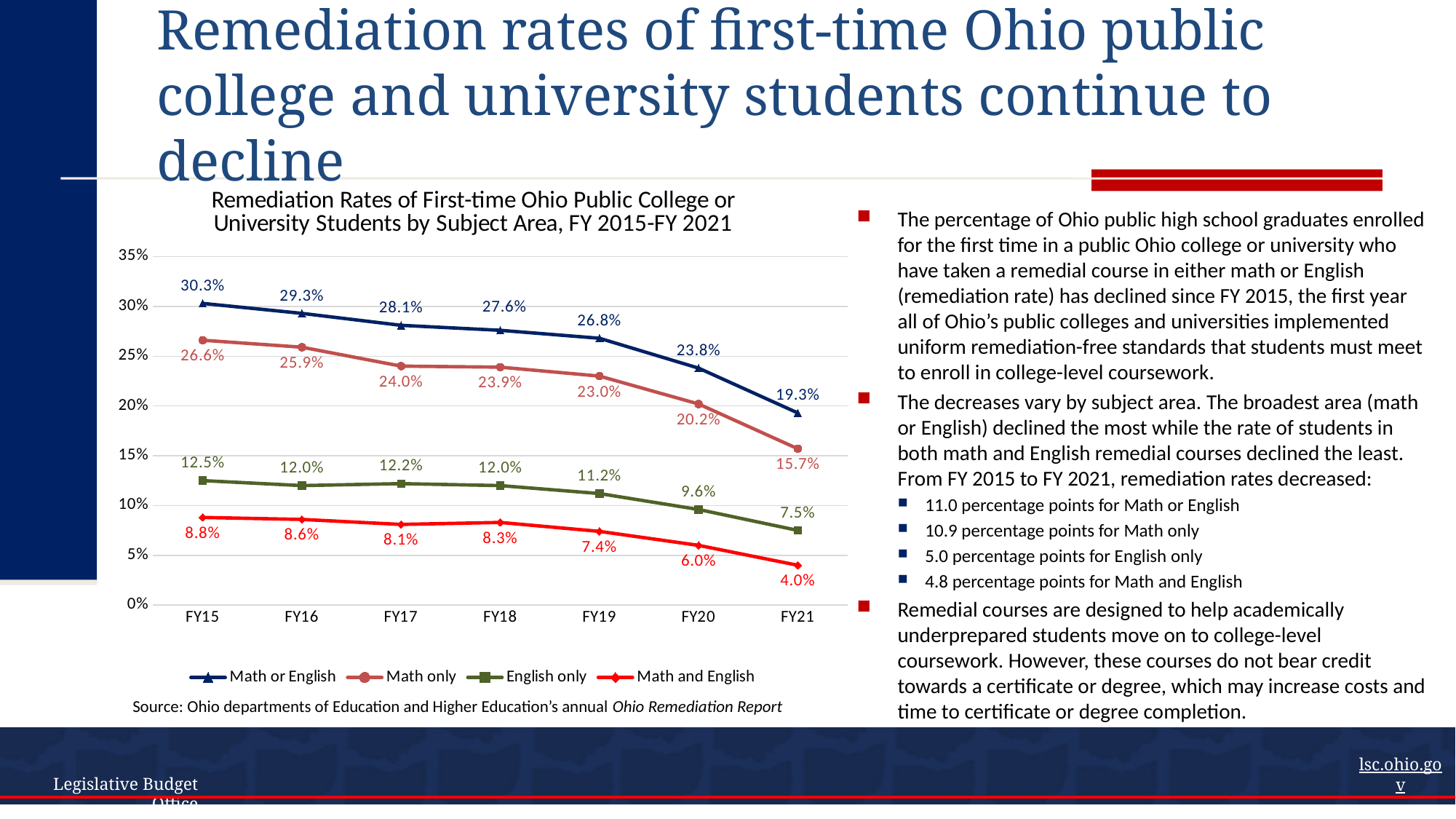
What is the Math only remediation rate in FY21? 15.7% What is the Math or English remediation rate in FY15? 30.3% What is the Math and English remediation rate in FY17? 8.1% What is the English only remediation rate in FY19? 11.2% Which is larger in FY20: the Math only rate or the English only rate? Math only By how many percentage points did the Math or English rate fall from FY15 to FY21? 11.0 percentage points In which fiscal year is the Math or English rate lowest? FY21 What kind of chart is shown on the slide? Line chart Do the Math only remediation rates rise or fall from FY15 to FY21? Fall How many series does the legend list? 4 In which fiscal year is the Math and English rate highest? FY15 How many fiscal years are plotted on the x axis? 7